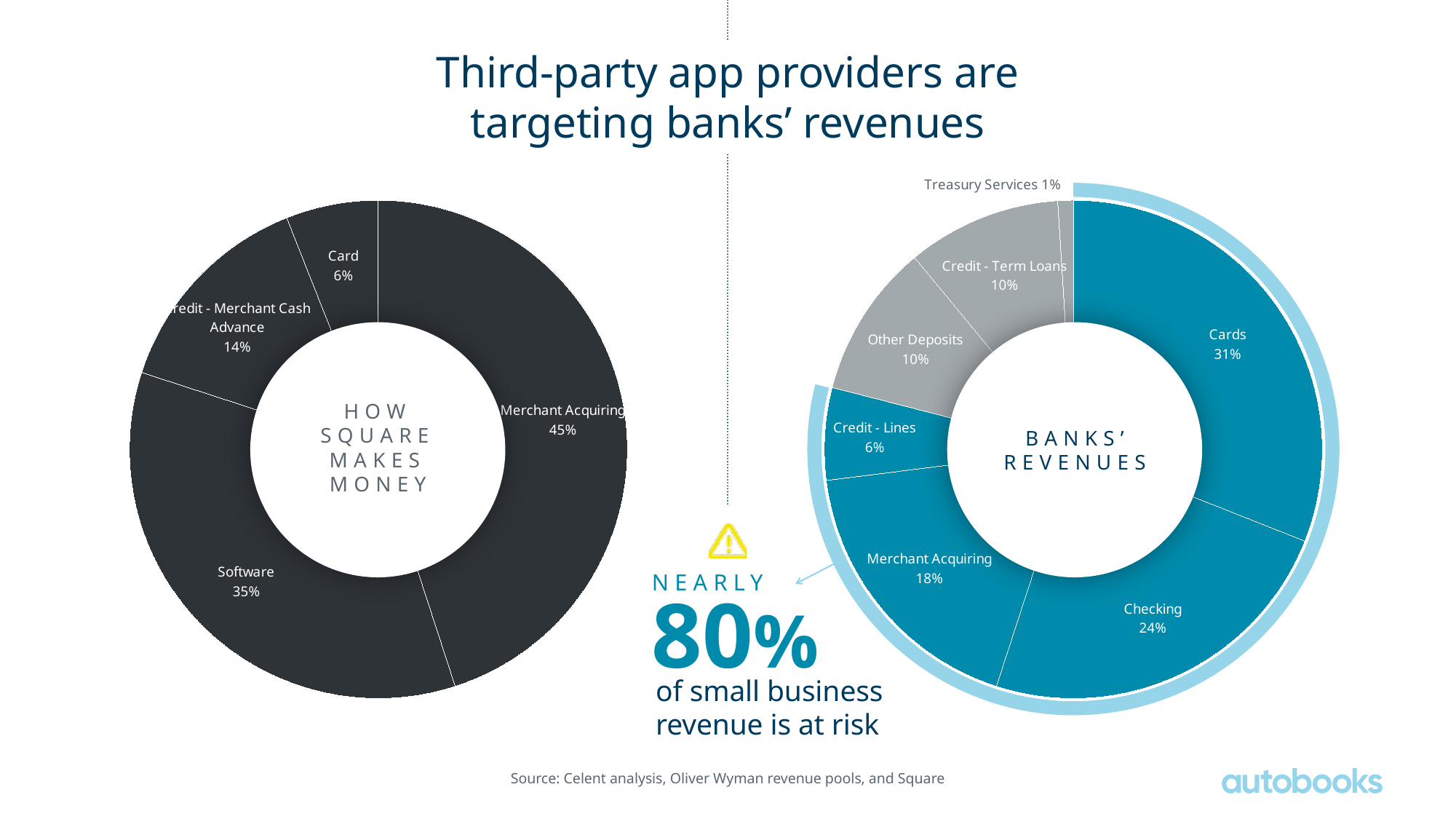
In the "How Square Makes Money" chart, what share does Software have? 35% In the "Banks' Revenues" chart, which category has the smallest share? Treasury Services In the "How Square Makes Money" chart, what is the difference between the Software share and the Credit - Merchant Cash Advance share? 21% In the "Banks' Revenues" chart, what is the combined share of Cards and Checking? 55% In the "How Square Makes Money" chart, how many categories are shown? 4 In the "Banks' Revenues" chart, which is larger: Merchant Acquiring or Credit - Lines? Merchant Acquiring In the "Banks' Revenues" chart, what share does Checking have? 24% In the "How Square Makes Money" chart, which category has the smallest share? Card What type of chart is the "Banks' Revenues" chart? Pie (donut) chart In the "Banks' Revenues" chart, how many categories are shown? 7 In the "How Square Makes Money" chart, what share does Merchant Acquiring have? 45% In the "Banks' Revenues" chart, which category has the largest share? Cards